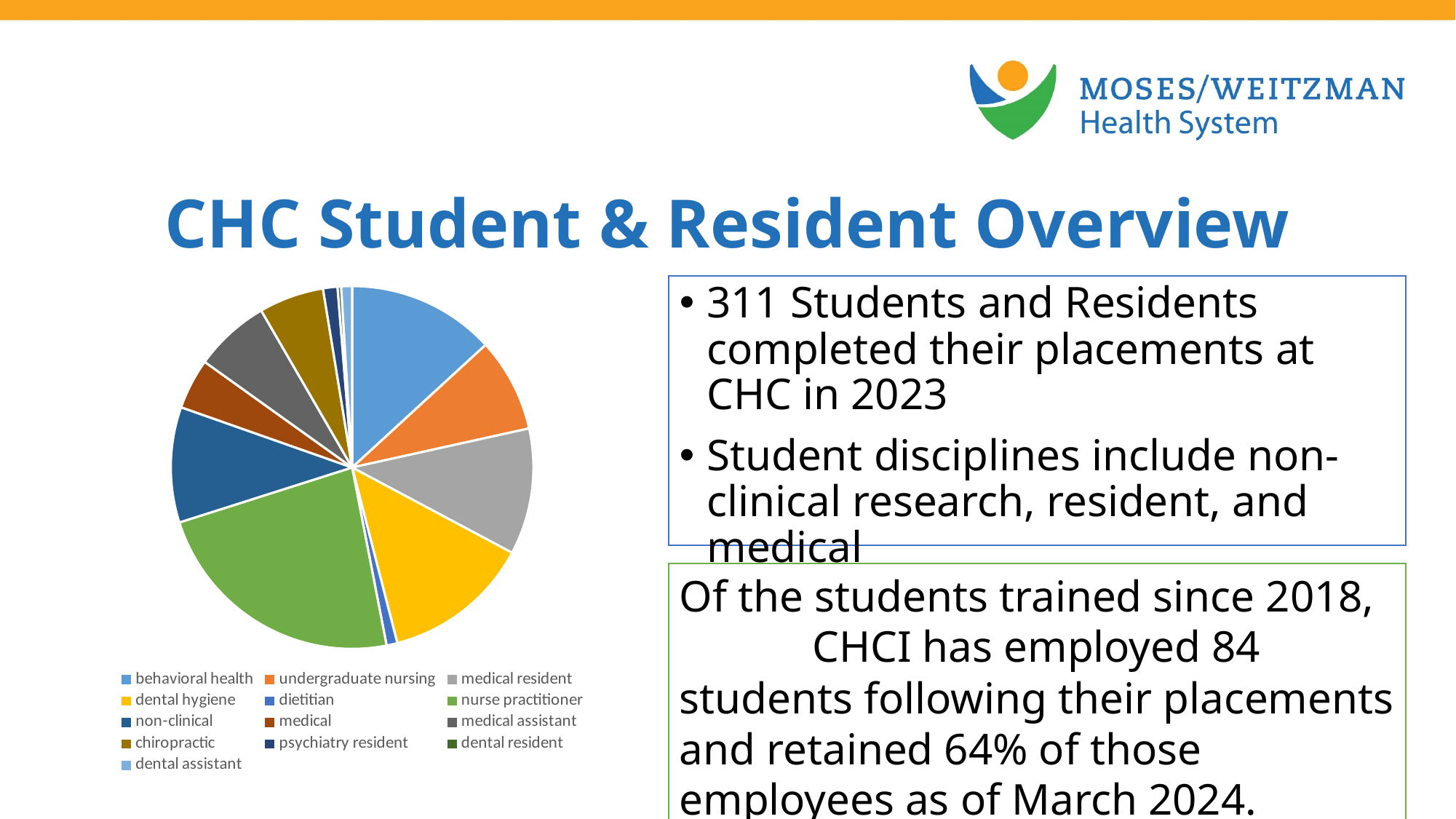
Which slice is larger in the pie chart, nurse practitioner or dietitian? nurse practitioner Which slice is larger in the pie chart, medical resident or psychiatry resident? medical resident What kind of chart is shown on the slide? pie chart Which slice is larger in the pie chart, non-clinical or chiropractic? non-clinical How many categories does the pie chart's legend list? 13 What colour is the nurse practitioner slice in the pie chart? green Where is the legend positioned relative to the pie chart? below the chart Which category has the largest slice in the pie chart? nurse practitioner